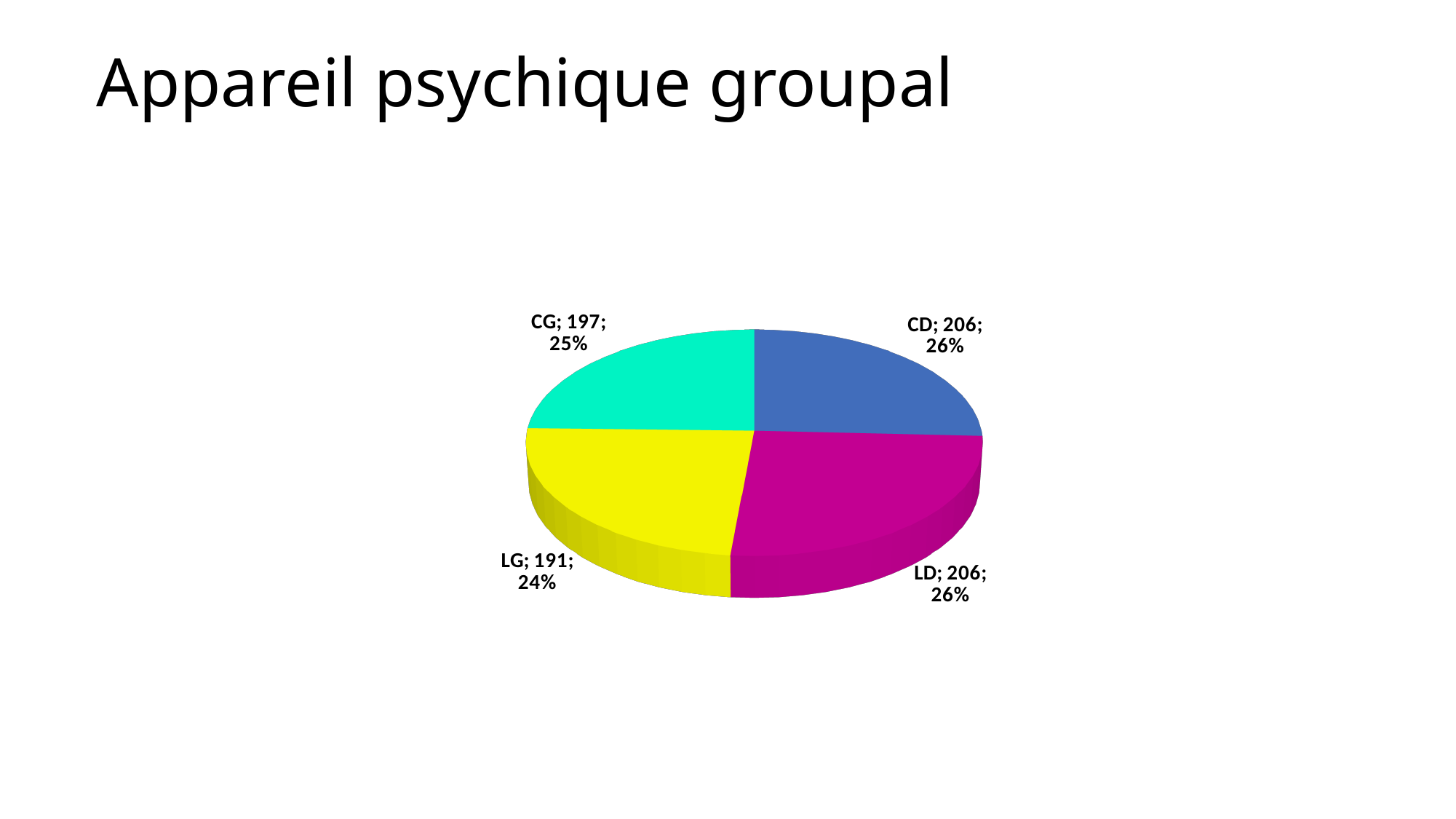
What kind of chart is shown on the slide? pie chart What is the value for LG? 191 How many slices does the pie chart have? 4 Which category has the lowest value? LG What is the value for LD? 206 What is the difference between the values for CG and LG? 6 What is the value for CG? 197 What is the value for CD? 206 What is the title of the slide containing the chart? Appareil psychique groupal Which is larger, the value for CG or the value for LG? CG What share of the pie does LG represent? 24% What is the difference between the values for CD and LG? 15